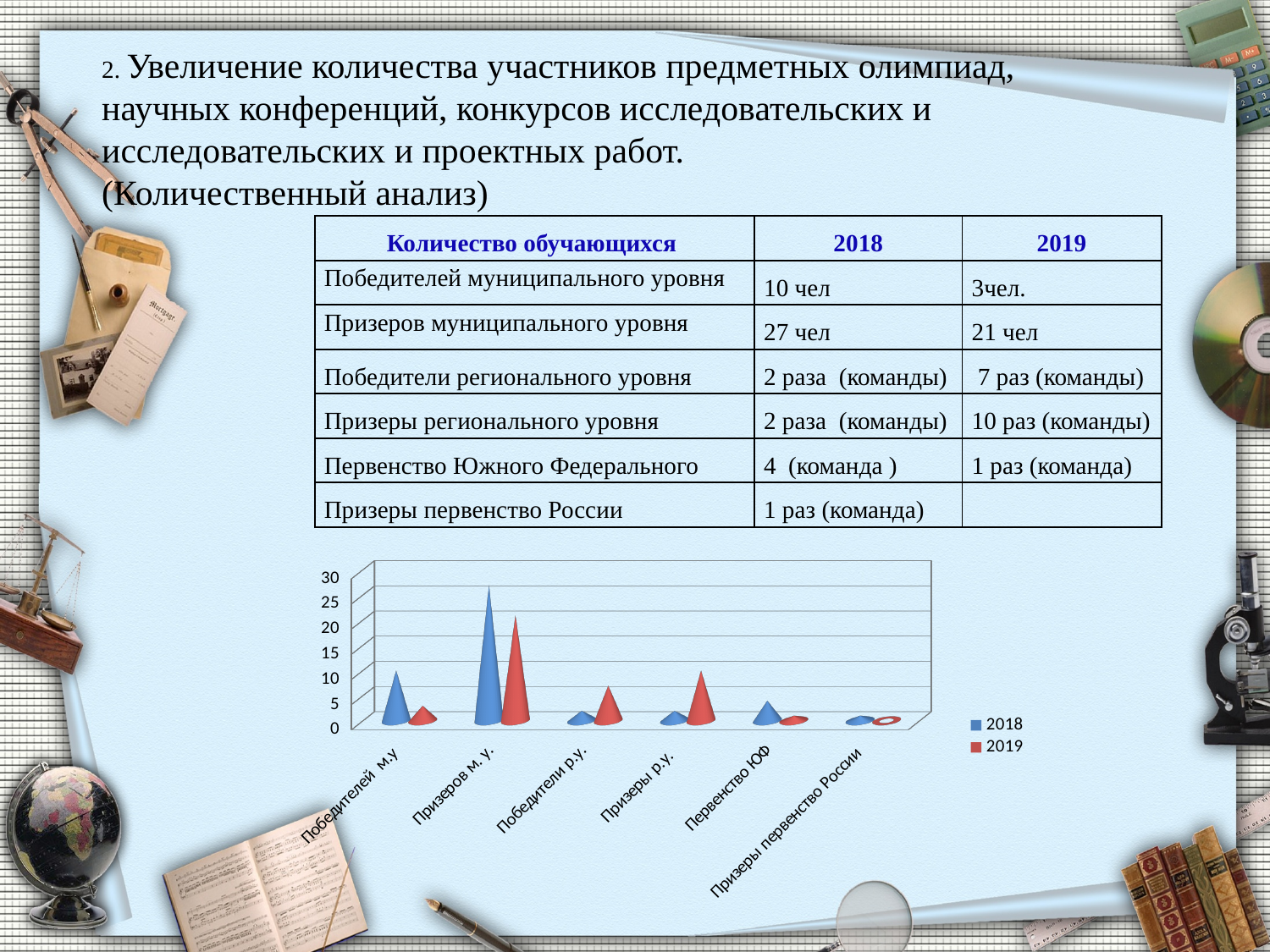
For Победителей м.у, which series has the larger value in the chart, 2018 or 2019? 2018 How many categories are shown along the x axis of the chart? 6 What are the two entries listed in the chart legend? 2018 and 2019 What is the 2018 value for Победителей м.у in the chart? 10 Is the 2018 value for Победители р.у. greater or less than 5? less Is the 2019 value for Призеров м. у. greater or less than 25? less How many series does the chart legend list? 2 What kind of chart is shown on the slide? bar chart Which category has the highest value for the 2018 series in the chart? Призеров м. у. Is the 2018 value for Призеров м. у. greater or less than 25? greater Which category has the highest value for the 2019 series in the chart? Призеров м. у. For Призеры р.у., which series has the larger value in the chart, 2018 or 2019? 2019